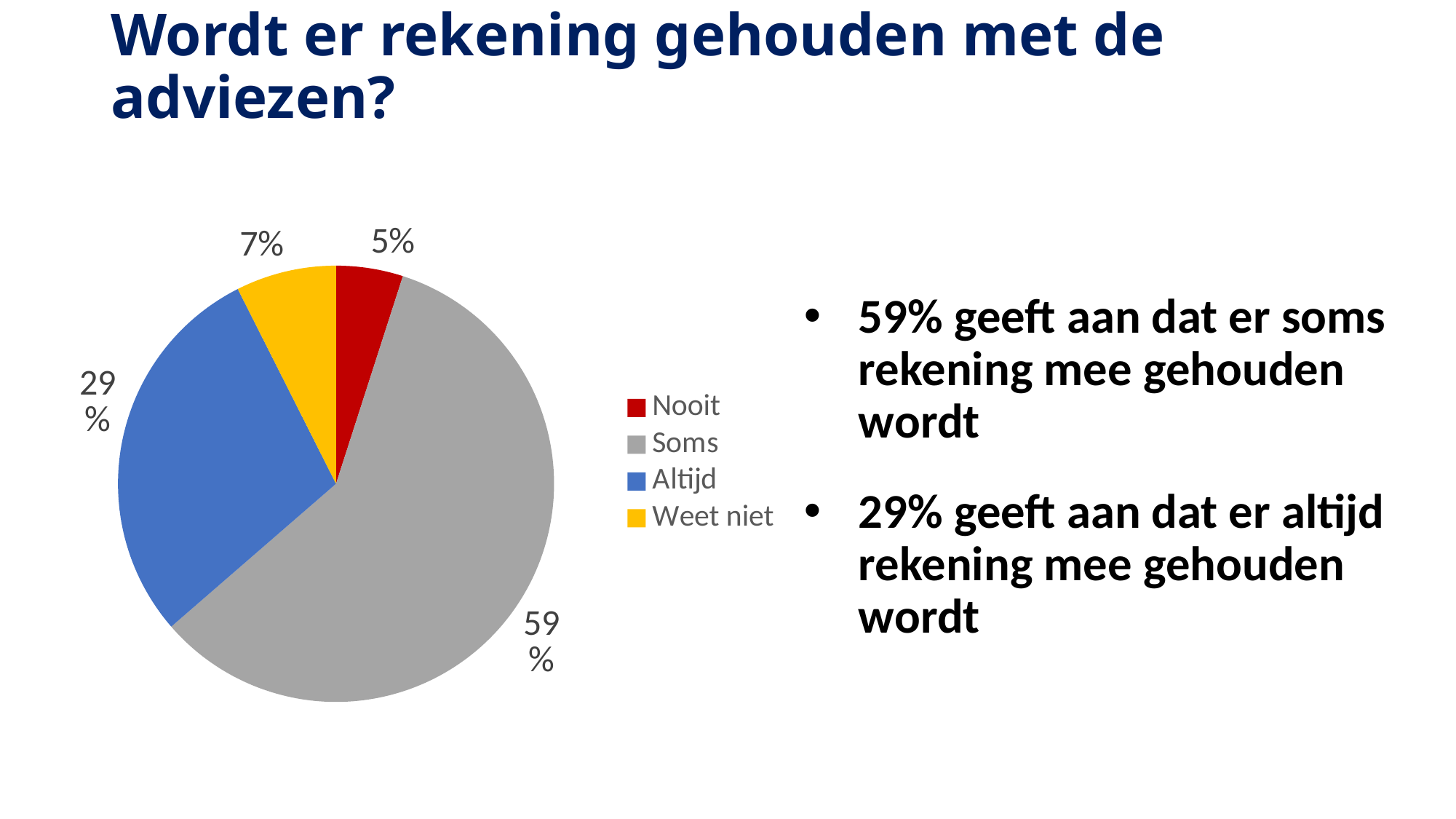
What percentage of the pie is the 'Altijd' slice? 29% What percentage of the pie is the 'Soms' slice? 59% Which category has the smallest slice of the pie? Nooit What is the difference in percentage points between the 'Soms' and 'Altijd' slices? 30 How many entries does the legend list? 4 Which slice is larger, 'Weet niet' or 'Nooit'? Weet niet What kind of chart is shown on the slide? pie chart How many categories does the pie chart have? 4 What colour is the 'Altijd' slice in the pie chart? blue Which category has the largest slice of the pie? Soms What percentage of the pie is the 'Nooit' slice? 5% What percentage of the pie is the 'Weet niet' slice? 7%